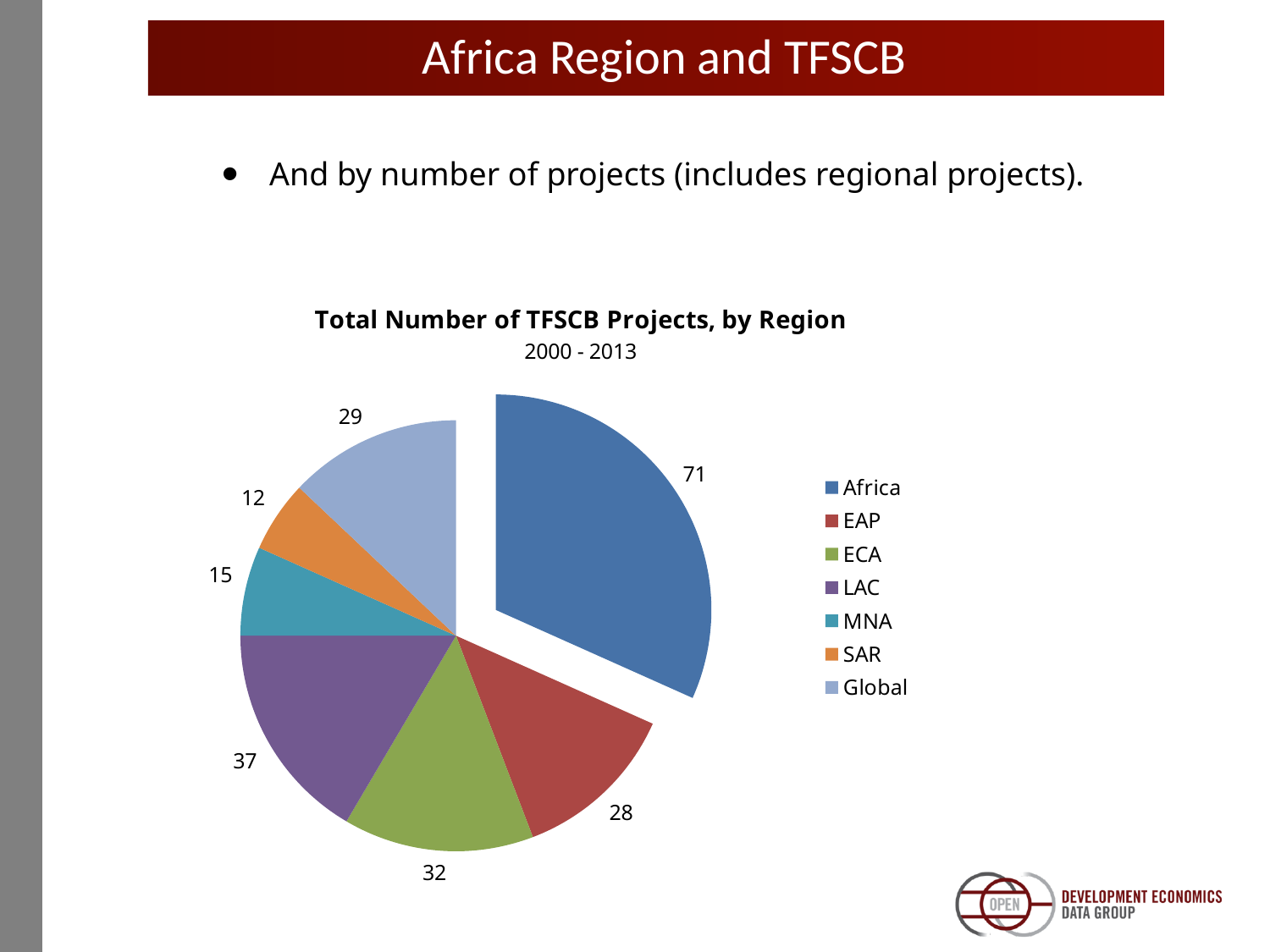
Which region has the smallest number of projects? SAR How many projects does the Africa slice represent? 71 What is the value shown for LAC? 37 What is the title of the chart? Total Number of TFSCB Projects, by Region How many regions does the legend list? 7 Which region has the largest number of projects? Africa What share of the total projects does the Global slice represent, to one decimal place? 12.9% What is the value shown for SAR? 12 What is the difference between the number of projects for Africa and for LAC? 34 Which has more projects, ECA or EAP? ECA What type of chart is shown on the slide? Pie chart What is the total number of projects across all slices of the pie? 224